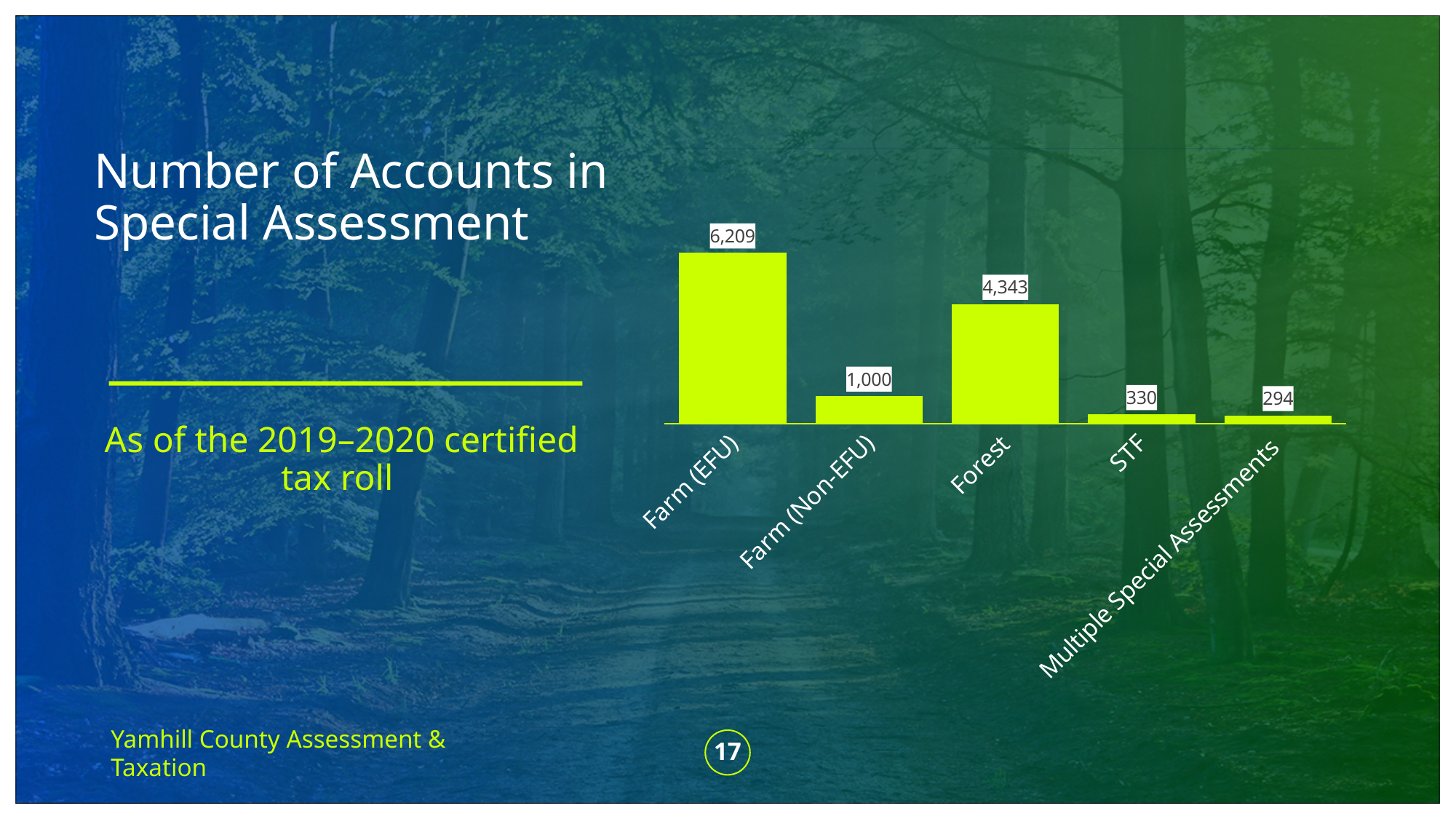
What is the difference between the Farm (EFU) and Forest values? 1,866 How many accounts are in the Farm (EFU) category? 6,209 What is the value shown for STF? 330 Which category has the highest number of accounts? Farm (EFU) What is the value shown for Farm (Non-EFU)? 1,000 What is the difference between the STF and Multiple Special Assessments values? 36 Which is larger, Forest or Farm (Non-EFU)? Forest What is the value shown for Forest? 4,343 What kind of chart is shown on the slide? Bar chart What is the value shown for Multiple Special Assessments? 294 How many categories are shown in the chart? 5 Which category has the lowest number of accounts? Multiple Special Assessments